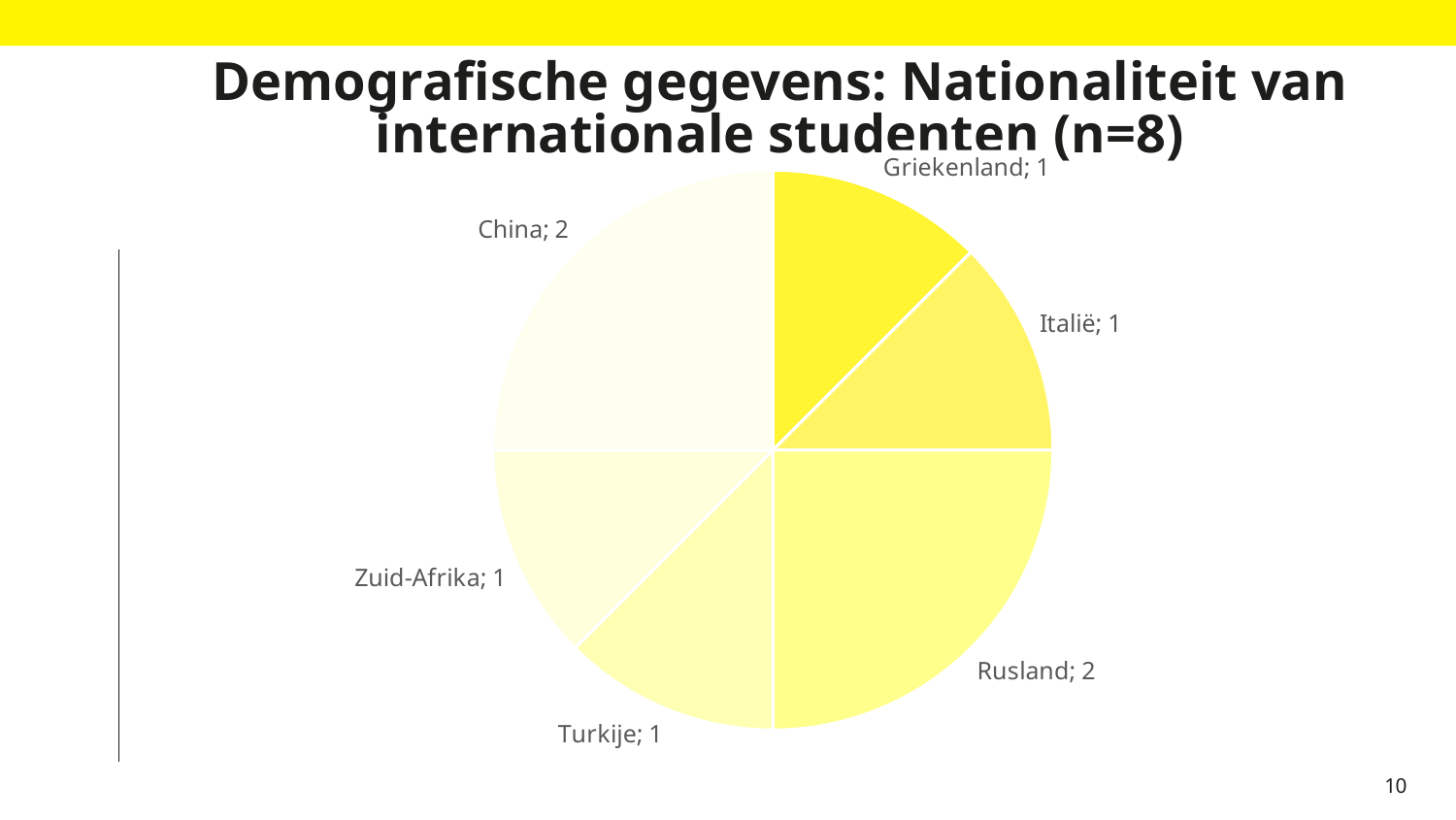
What share of the pie does China represent? 25% What is the difference between the value for China and the value for Italië? 1 What is the total of all the slices in the pie chart? 8 What is the value for Griekenland in the pie chart? 1 How many slices does the pie chart have? 6 Which is larger, the value for Rusland or the value for Turkije? Rusland What is the value for China in the pie chart? 2 What kind of chart is shown on the slide? pie chart What share of the pie does Turkije represent? 12.5% What is the title of the slide containing the pie chart? Demografische gegevens: Nationaliteit van internationale studenten (n=8) What is the value for Zuid-Afrika in the pie chart? 1 What is the value for Rusland in the pie chart? 2